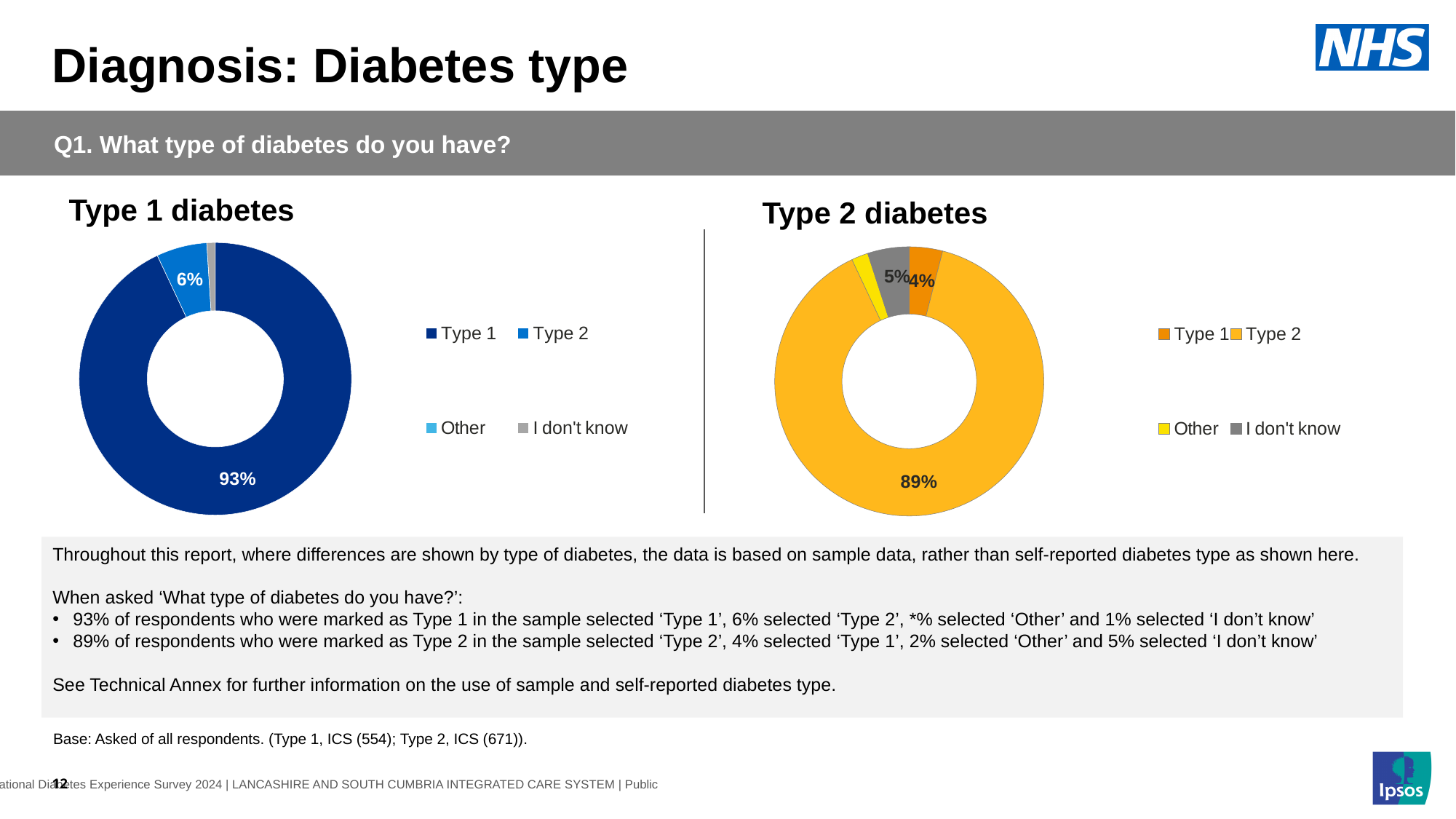
In the 'Type 2 diabetes' chart, which slice is larger: 'I don't know' or 'Type 1'? I don't know In the 'Type 2 diabetes' chart, what share of respondents selected 'Type 1'? 4% In the 'Type 1 diabetes' chart, what share of respondents selected 'Type 1'? 93% What kind of chart is used on this slide to show diabetes type? Donut (pie) chart In the 'Type 1 diabetes' chart, how many percentage points larger is the 'Type 1' slice than the 'Type 2' slice? 87 percentage points In the 'Type 2 diabetes' chart, what share of respondents selected 'I don't know'? 5% In the 'Type 1 diabetes' chart, which category has the largest slice? Type 1 In the 'Type 2 diabetes' chart, how many percentage points larger is the 'Type 2' slice than the 'Type 1' slice? 85 percentage points In the 'Type 2 diabetes' chart, what share of respondents selected 'Type 2'? 89% In the 'Type 1 diabetes' chart, what share of respondents selected 'Type 2'? 6% In the 'Type 2 diabetes' chart, which category has the largest slice? Type 2 How many categories does the legend of the 'Type 1 diabetes' chart list? 4